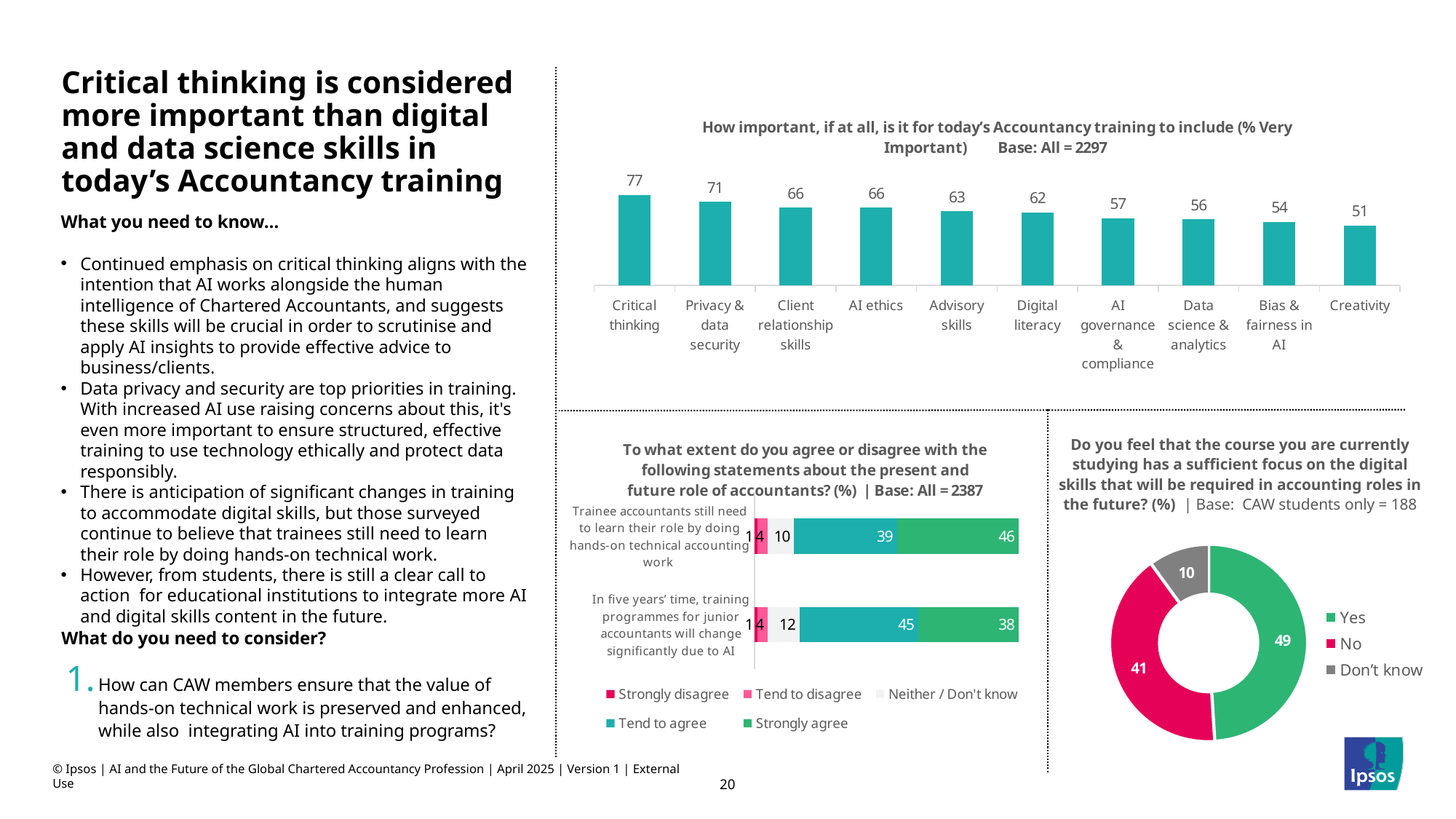
In the bottom-left stacked bar chart about the role of accountants, what is the Strongly agree value for the statement that trainee accountants still need to learn their role by doing hands-on technical accounting work? 46 In the top bar chart on accountancy training, what is the difference between Privacy & data security and Data science & analytics? 15 In the top bar chart on accountancy training, what is the value for Critical thinking? 77 In the bottom-left stacked bar chart about the role of accountants, what is the Tend to agree value for the statement that training programmes for junior accountants will change significantly due to AI in five years' time? 45 In the top bar chart on accountancy training, what is the value for AI governance & compliance? 57 In the top bar chart on accountancy training, how many categories are shown? 10 What type of chart is the bottom-right chart on sufficient focus on digital skills? Donut chart In the top bar chart on accountancy training, which is larger: Digital literacy or Bias & fairness in AI? Digital literacy In the top bar chart on accountancy training, which category has the lowest value? Creativity How many series does the legend of the bottom-left stacked bar chart list? 5 In the bottom-right donut chart on sufficient focus on digital skills, which response has the smallest share? Don't know In the bottom-right donut chart on sufficient focus on digital skills, what share of respondents answered Yes? 49